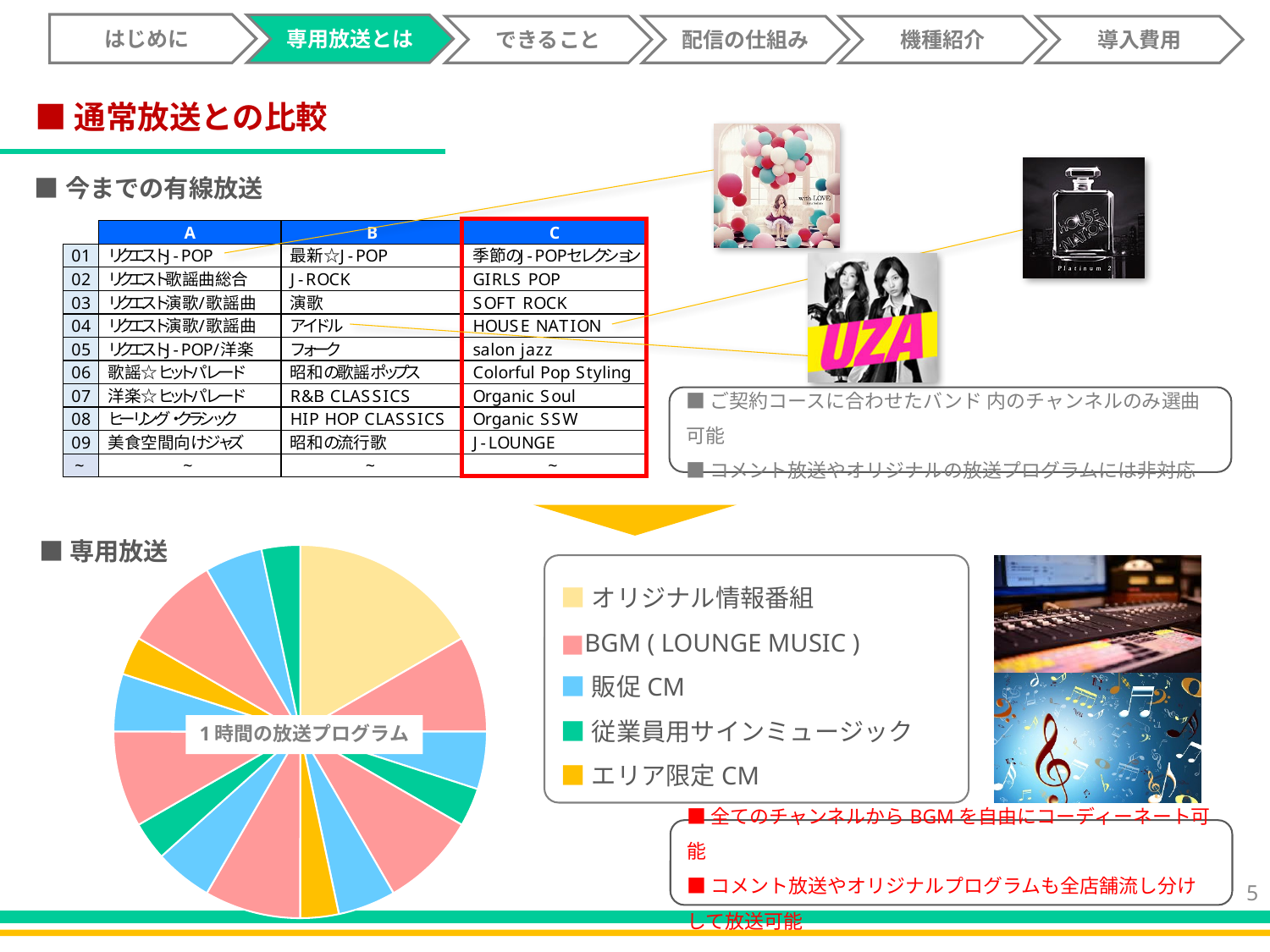
What label is printed in the centre of the pie chart? 1時間の放送プログラム How many entries does the legend of the pie chart list? 5 Which legend entry of the pie chart is shown in orange? エリア限定 CM What kind of chart is shown under the heading 専用放送 on the slide? pie chart Which legend category does the largest single slice of the pie chart belong to? オリジナル情報番組